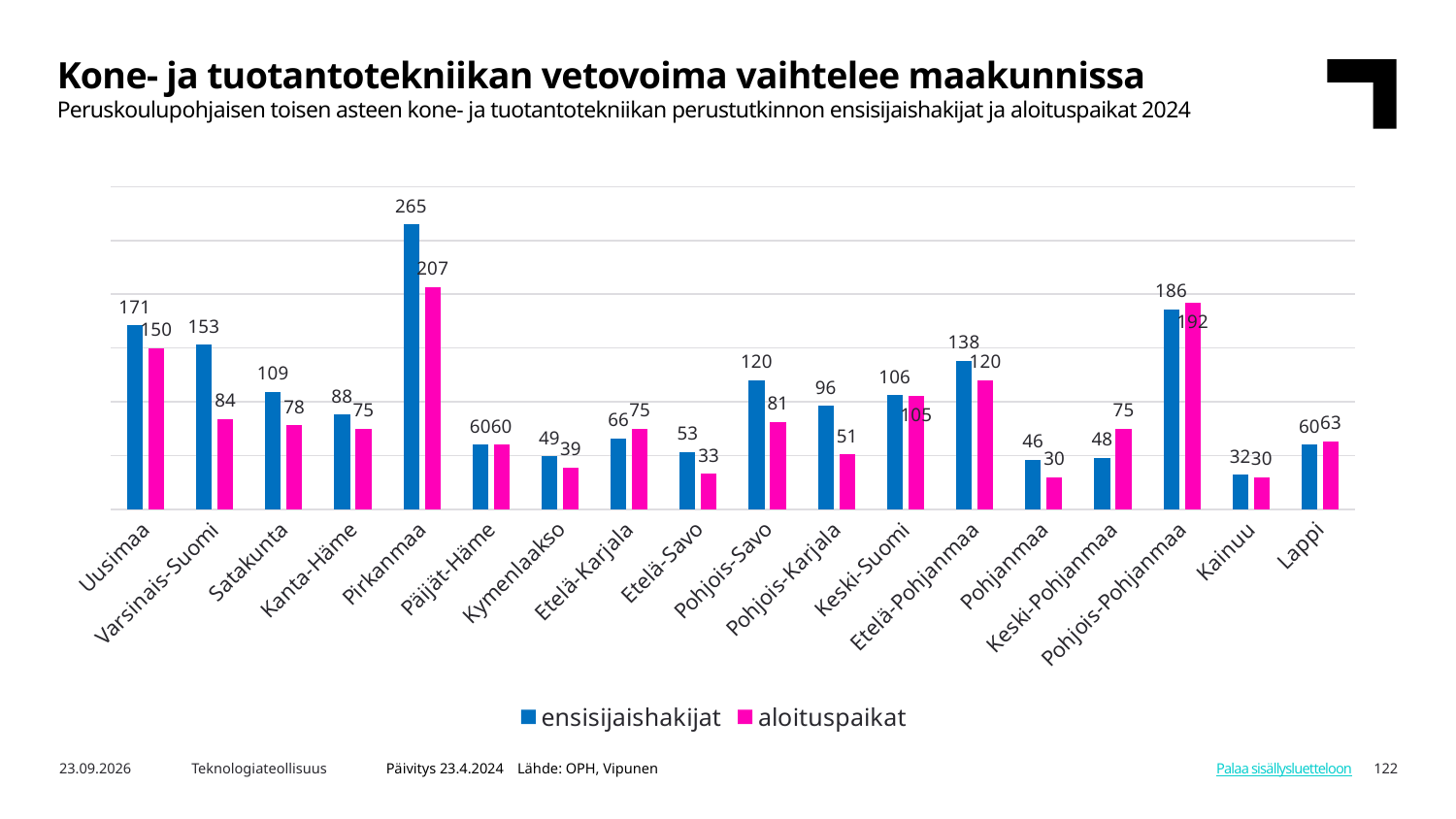
Which is larger: ensisijaishakijat for Etelä-Pohjanmaa or for Pohjois-Savo? Etelä-Pohjanmaa What is the difference between ensisijaishakijat and aloituspaikat for Pohjois-Savo? 39 What is the value of aloituspaikat for Varsinais-Suomi? 84 What is the difference between ensisijaishakijat for Uusimaa and Varsinais-Suomi? 18 Which is larger for Keski-Pohjanmaa: ensisijaishakijat or aloituspaikat? aloituspaikat Which region has the lowest value of aloituspaikat? Pohjanmaa and Kainuu (both 30) What is the value of ensisijaishakijat for Pirkanmaa? 265 What kind of chart is shown on the slide? bar chart What is the value of aloituspaikat for Pohjois-Pohjanmaa? 192 How many regions are shown on the x axis? 18 How many series does the legend list? 2 Which region has the highest value of ensisijaishakijat? Pirkanmaa